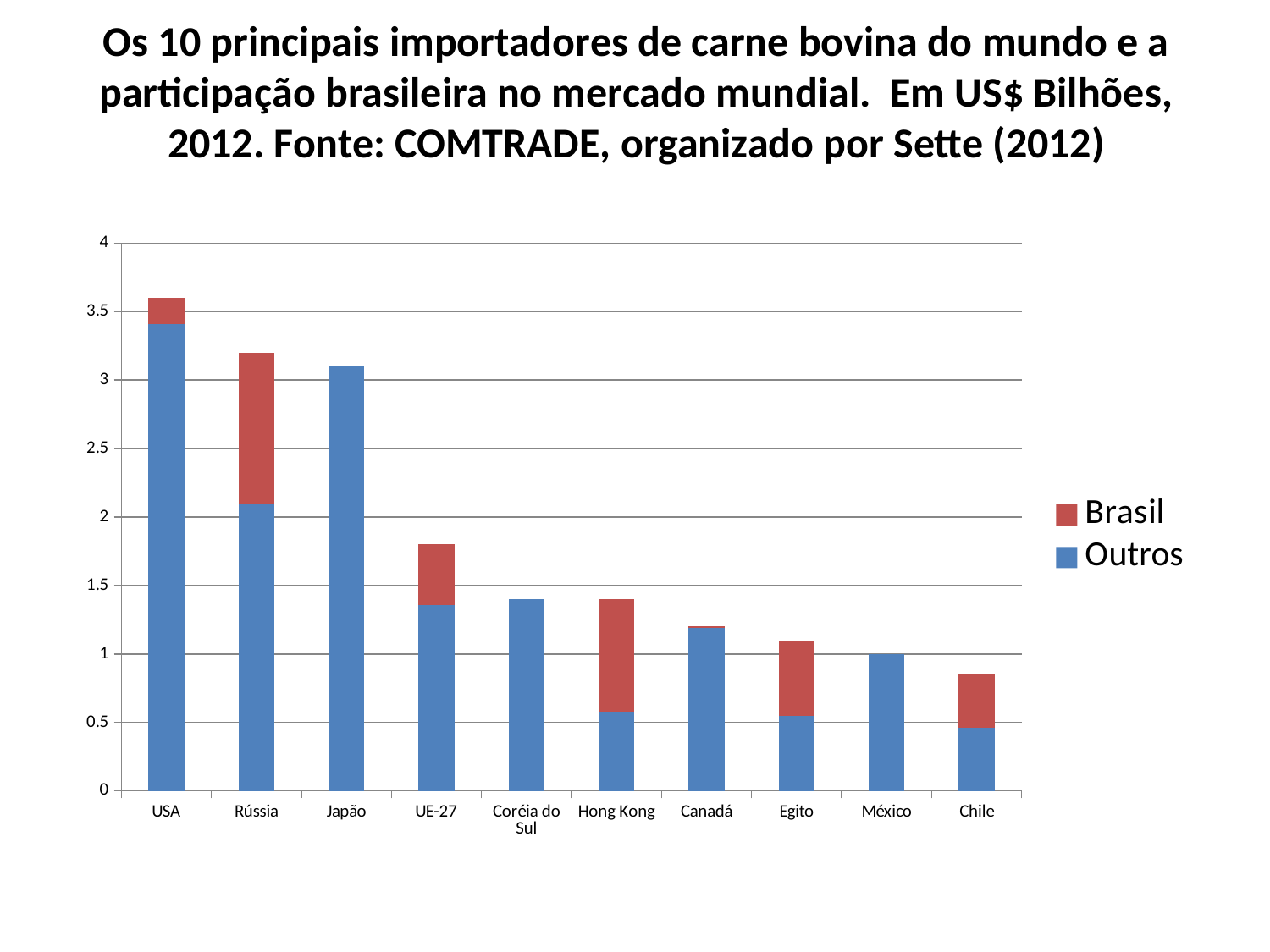
What kind of chart is shown on the slide? Stacked bar chart Which country has the lowest total bar in the chart? Chile Is the total bar for UE-27 greater or less than 2? less Is the Outros value for Hong Kong greater or less than 1? less Is the total bar for Chile greater or less than 1? less Which has the larger total bar, USA or Rússia? USA Which has the larger Brasil segment, Rússia or Hong Kong? Rússia Do the total bar values generally rise or fall from left to right along the x axis? fall Which country has the highest total bar in the chart? USA How many countries are shown on the x axis of the chart? 10 How many series does the chart legend list? 2